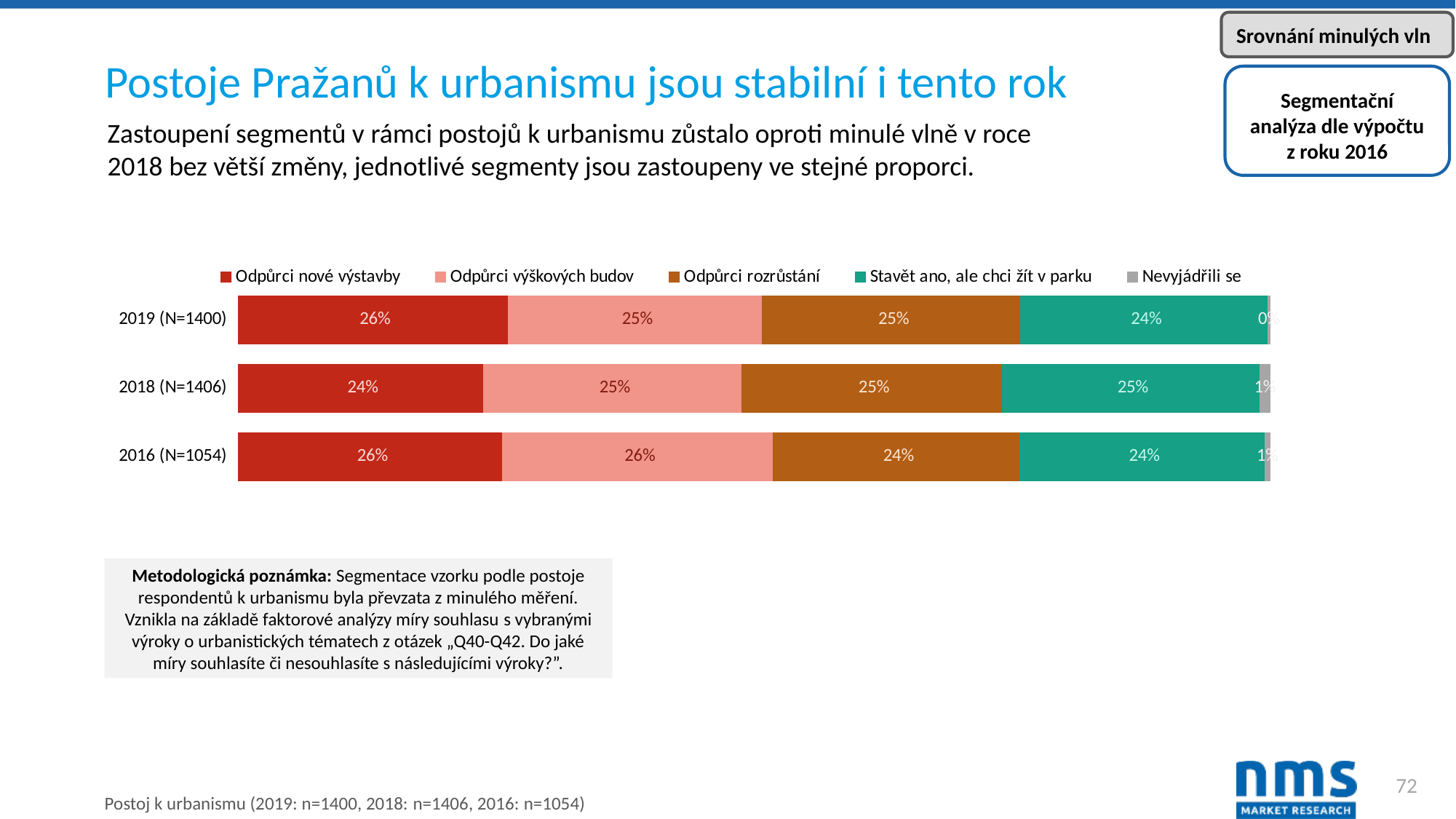
What is the value for Odpůrci nové výstavby in the 2018 (N=1406) bar? 24% What kind of chart is shown on the slide? Stacked bar chart How many bars (years) does the chart show? 3 What is the value for Stavět ano, ale chci žít v parku in the 2018 (N=1406) bar? 25% What is the value for Odpůrci rozrůstání in the 2016 (N=1054) bar? 24% How many series does the legend list? 5 What is the value for Odpůrci výškových budov in the 2016 (N=1054) bar? 26% What is the value for Nevyjádřili se in the 2019 (N=1400) bar? 0% What is the value for Odpůrci nové výstavby in the 2019 (N=1400) bar? 26% What is the difference between the Odpůrci nové výstavby value in 2019 (N=1400) and in 2018 (N=1406)? 2 percentage points Which colour represents Nevyjádřili se in the legend? Grey In the 2019 (N=1400) bar, which is larger: Odpůrci nové výstavby or Stavět ano, ale chci žít v parku? Odpůrci nové výstavby